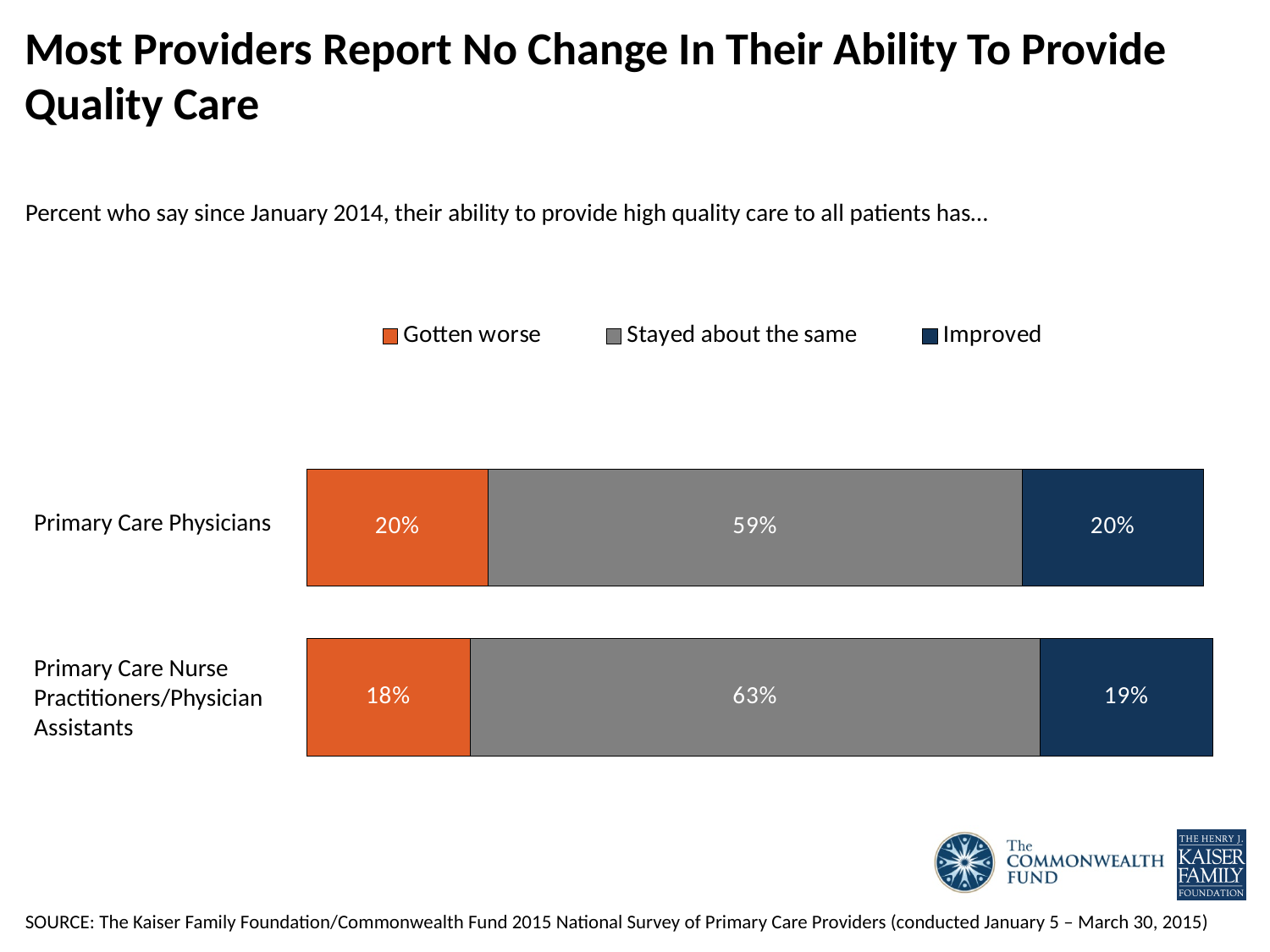
What percent of Primary Care Nurse Practitioners/Physician Assistants say their ability to provide high quality care has gotten worse? 18% What percent of Primary Care Physicians say their ability to provide high quality care has stayed about the same? 59% How many provider groups are shown in the chart? 2 What is the difference between the 'Stayed about the same' values for Primary Care Nurse Practitioners/Physician Assistants and Primary Care Physicians? 4 percentage points What is the total of the three segments for the Primary Care Physicians bar? 99% Which provider group has the higher share saying their ability to provide quality care stayed about the same? Primary Care Nurse Practitioners/Physician Assistants Which response category is shown in orange in the legend? Gotten worse What kind of chart is shown on the slide? Stacked bar chart Is the 'Gotten worse' value larger for Primary Care Physicians or for Primary Care Nurse Practitioners/Physician Assistants? Primary Care Physicians What percent of Primary Care Physicians say their ability to provide high quality care has gotten worse? 20% How many series does the legend list? 3 What percent of Primary Care Nurse Practitioners/Physician Assistants say their ability to provide high quality care has improved? 19%